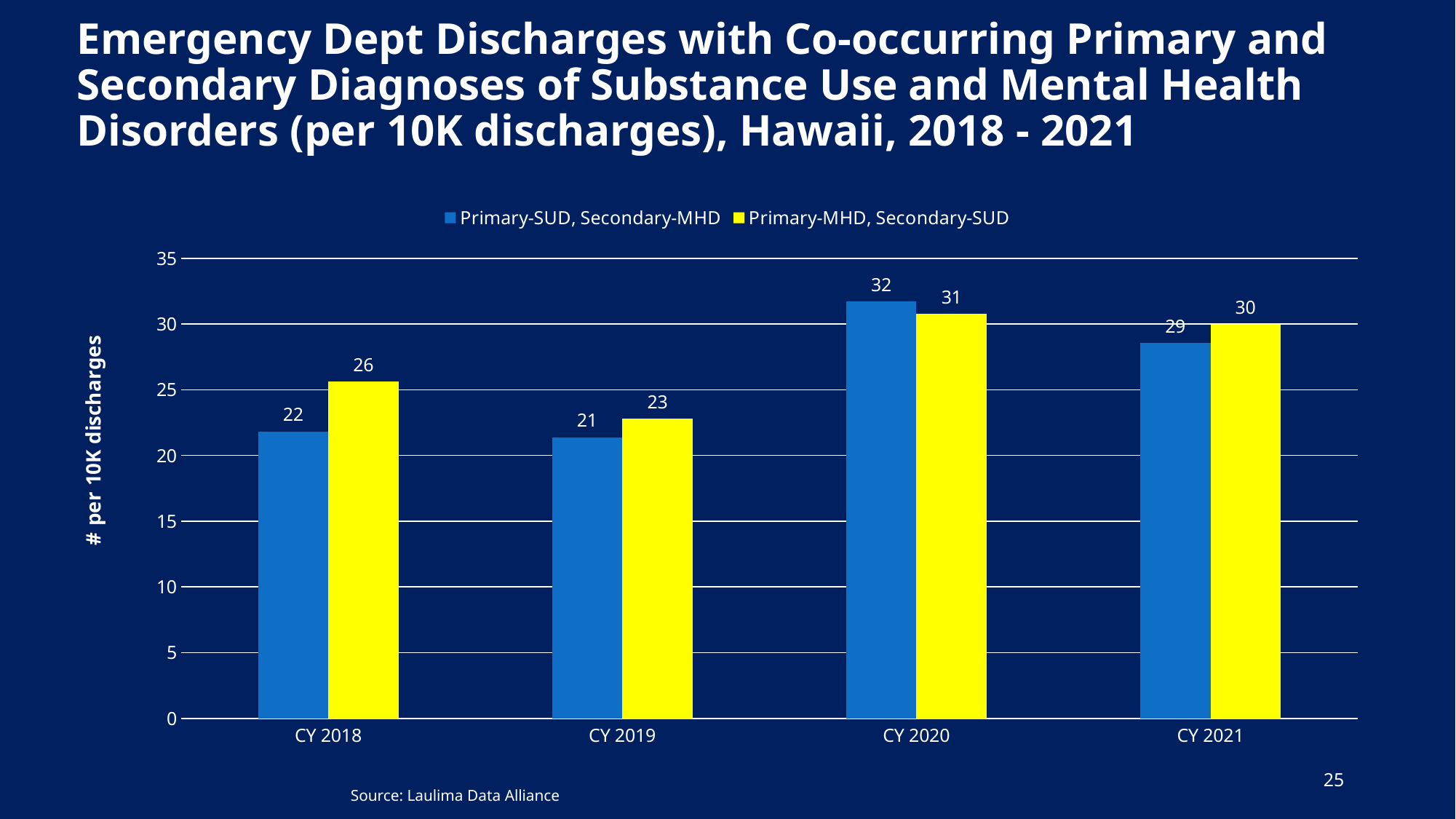
Is the value for Primary-SUD, Secondary-MHD in CY 2021 greater or less than 25? greater In which year is the Primary-SUD, Secondary-MHD value lowest? CY 2019 What is the label of the y axis? # per 10K discharges Which series has the larger value in CY 2020? Primary-SUD, Secondary-MHD What is the value for Primary-MHD, Secondary-SUD in CY 2021? 30 What is the value for Primary-SUD, Secondary-MHD in CY 2020? 32 How many series does the legend list? 2 In which year is the Primary-MHD, Secondary-SUD value highest? CY 2020 What is the difference between the Primary-MHD, Secondary-SUD value and the Primary-SUD, Secondary-MHD value in CY 2018? 4 What kind of chart is shown on the slide? Bar chart What is the value for Primary-SUD, Secondary-MHD in CY 2018? 22 How many years are shown on the x axis? 4